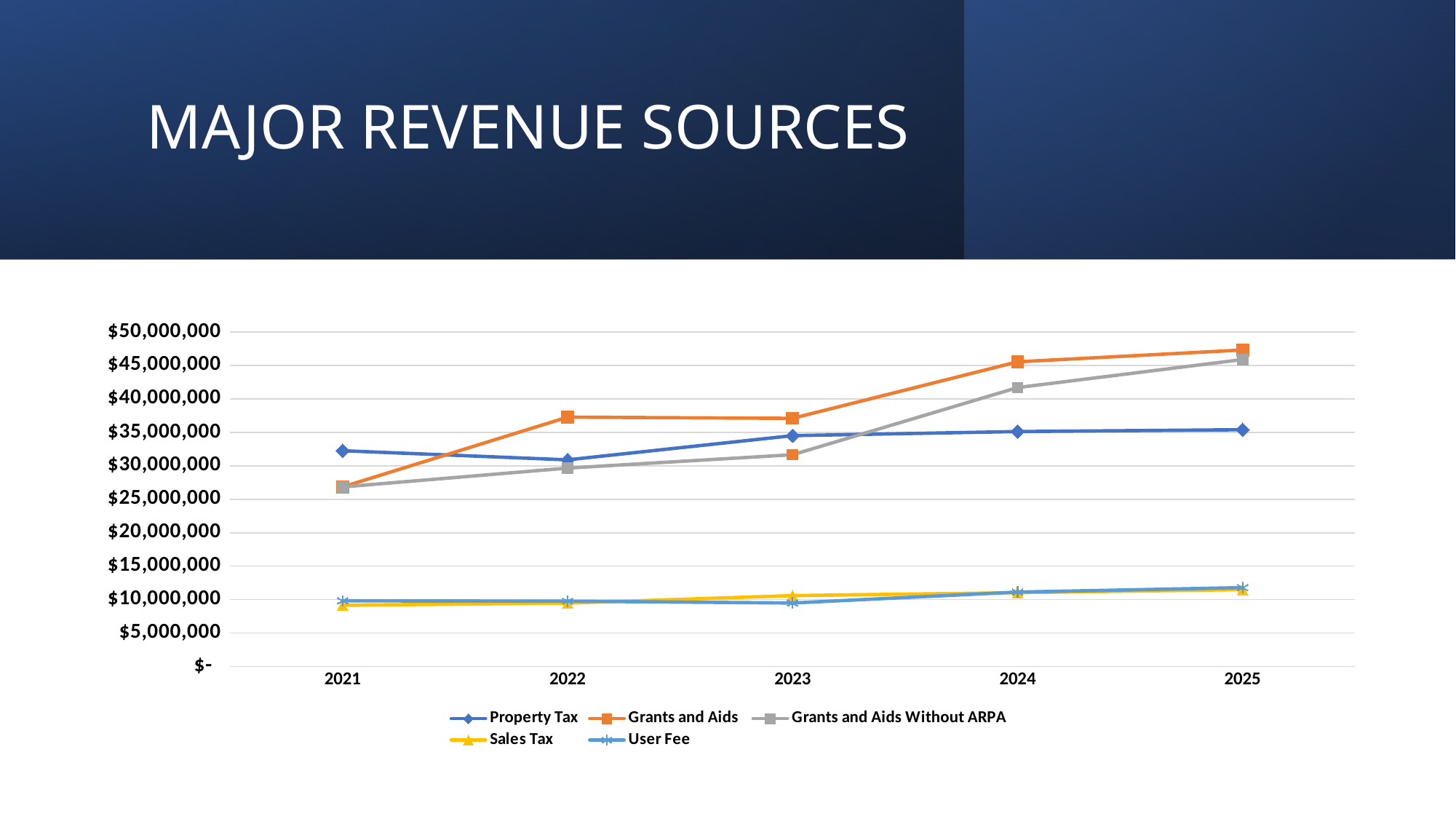
Which series has the highest value in 2024? Grants and Aids In 2023, which is larger: Property Tax or Grants and Aids Without ARPA? Property Tax What kind of chart is shown on the slide? line chart In 2022, which is larger: Property Tax or Grants and Aids? Grants and Aids In which year is Property Tax at its lowest? 2022 In which year is Grants and Aids at its lowest? 2021 Is the value for User Fee in 2025 greater or less than $15,000,000? less Is the value for Property Tax in 2021 greater or less than $30,000,000? greater How many years are shown on the x axis? 5 How many series does the legend list? 5 Is the value for Grants and Aids in 2024 greater or less than $40,000,000? greater Does the Grants and Aids Without ARPA line rise or fall from 2021 to 2025? rises